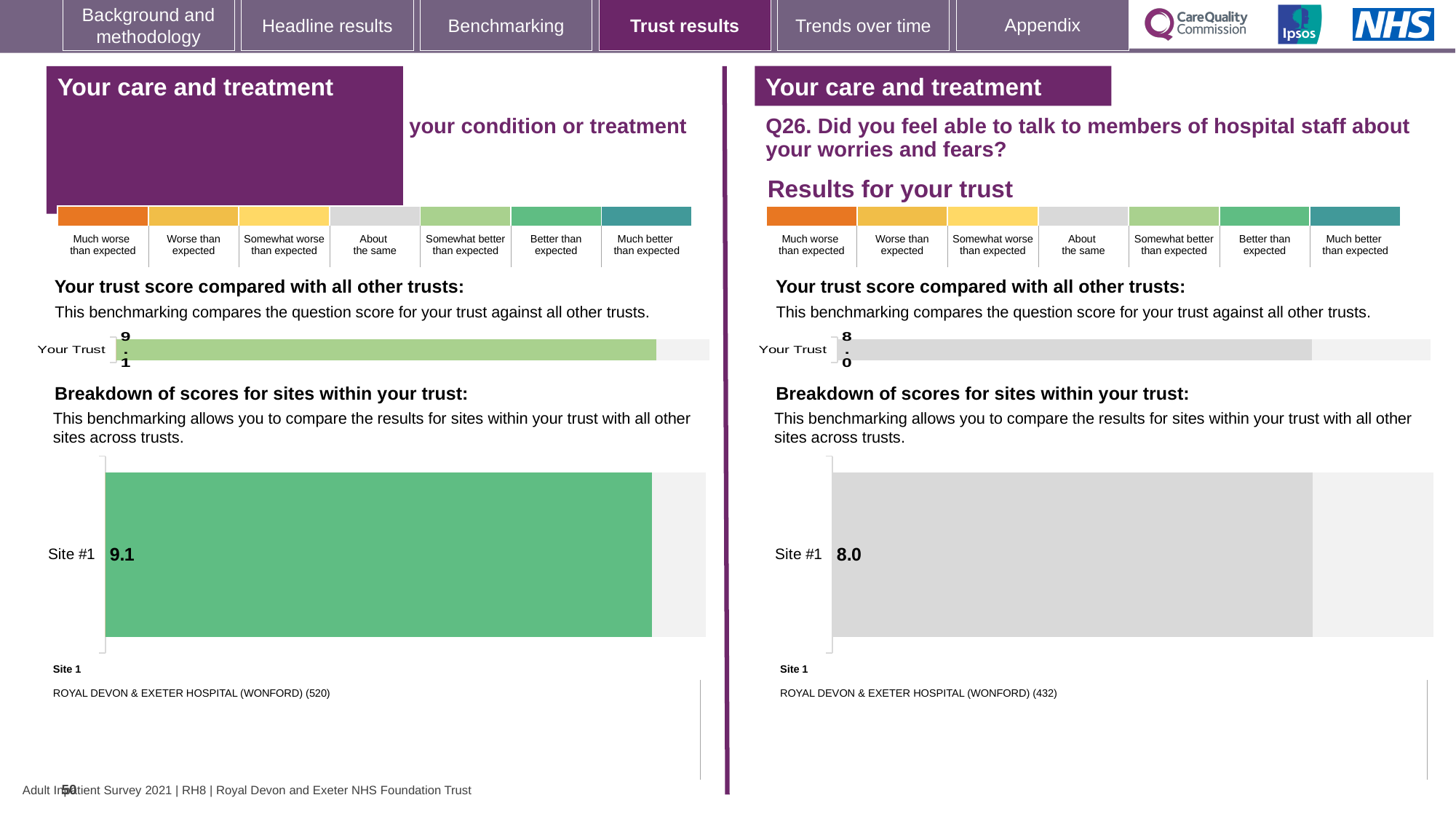
What is the difference between the Site #1 score on the left-hand breakdown chart and the Site #1 score on the right-hand breakdown chart? 1.1 On the left-hand 'Breakdown of scores for sites within your trust' chart, what is the score for Site #1? 9.1 Which hospital is listed as Site 1 beneath the right-hand breakdown chart? ROYAL DEVON & EXETER HOSPITAL (WONFORD) What colour is the Site #1 bar in the right-hand breakdown chart (Q26)? Grey How many sites are shown in the left-hand 'Breakdown of scores for sites within your trust' chart? 1 On the right-hand 'Breakdown of scores for sites within your trust' chart (Q26), what is the score for Site #1? 8.0 On the left-hand 'Your trust score compared with all other trusts' chart, what is the value shown for Your Trust? 9.1 Which Site #1 score is larger: the one on the left-hand breakdown chart or the one on the right-hand breakdown chart (Q26)? The left-hand chart (9.1) What kind of chart is used for the 'Breakdown of scores for sites within your trust' on the right-hand side? Bar chart On the left-hand side, is the Site #1 score greater or less than the Your Trust score, or are they equal? Equal On the right-hand 'Your trust score compared with all other trusts' chart (Q26), is the Your Trust value greater or less than 9? less On the right-hand 'Your trust score compared with all other trusts' chart (Q26), what is the value shown for Your Trust? 8.0